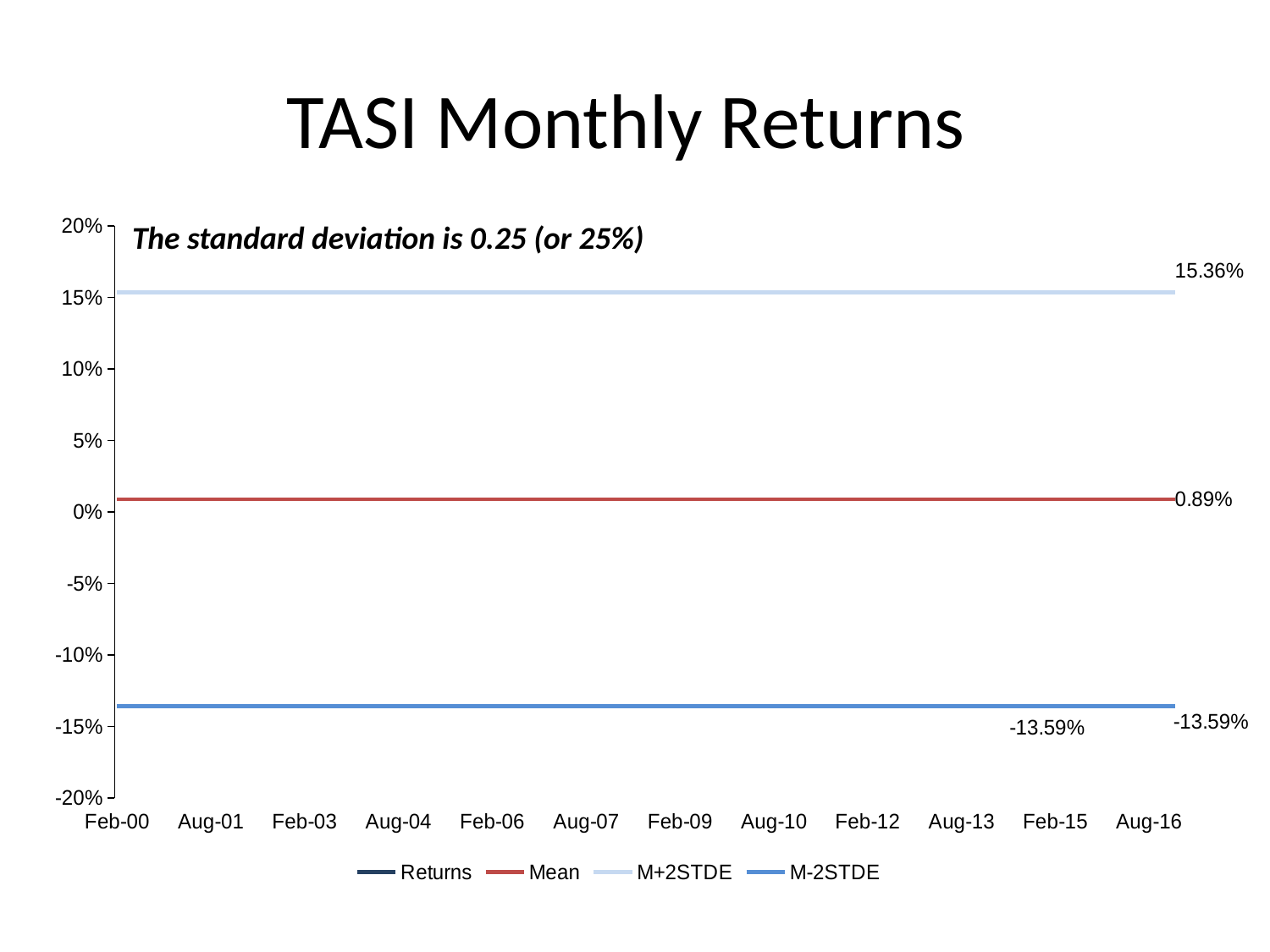
Which plotted line has the lowest value? M-2STDE Does the Mean line rise, fall, or stay flat across the x axis? Stays flat What is the difference between the M+2STDE value and the Mean value? 14.47% What is the title of the chart? TASI Monthly Returns Which plotted line has the highest value? M+2STDE Is the value of the M+2STDE line greater or less than 10%? greater What is the value of the Mean line? 0.89% What is the value of the M-2STDE line? -13.59% What is the value of the M+2STDE line? 15.36% How many series does the legend list? 4 What type of chart is shown on the slide? Line chart Which is larger, the Mean value or the M-2STDE value? Mean